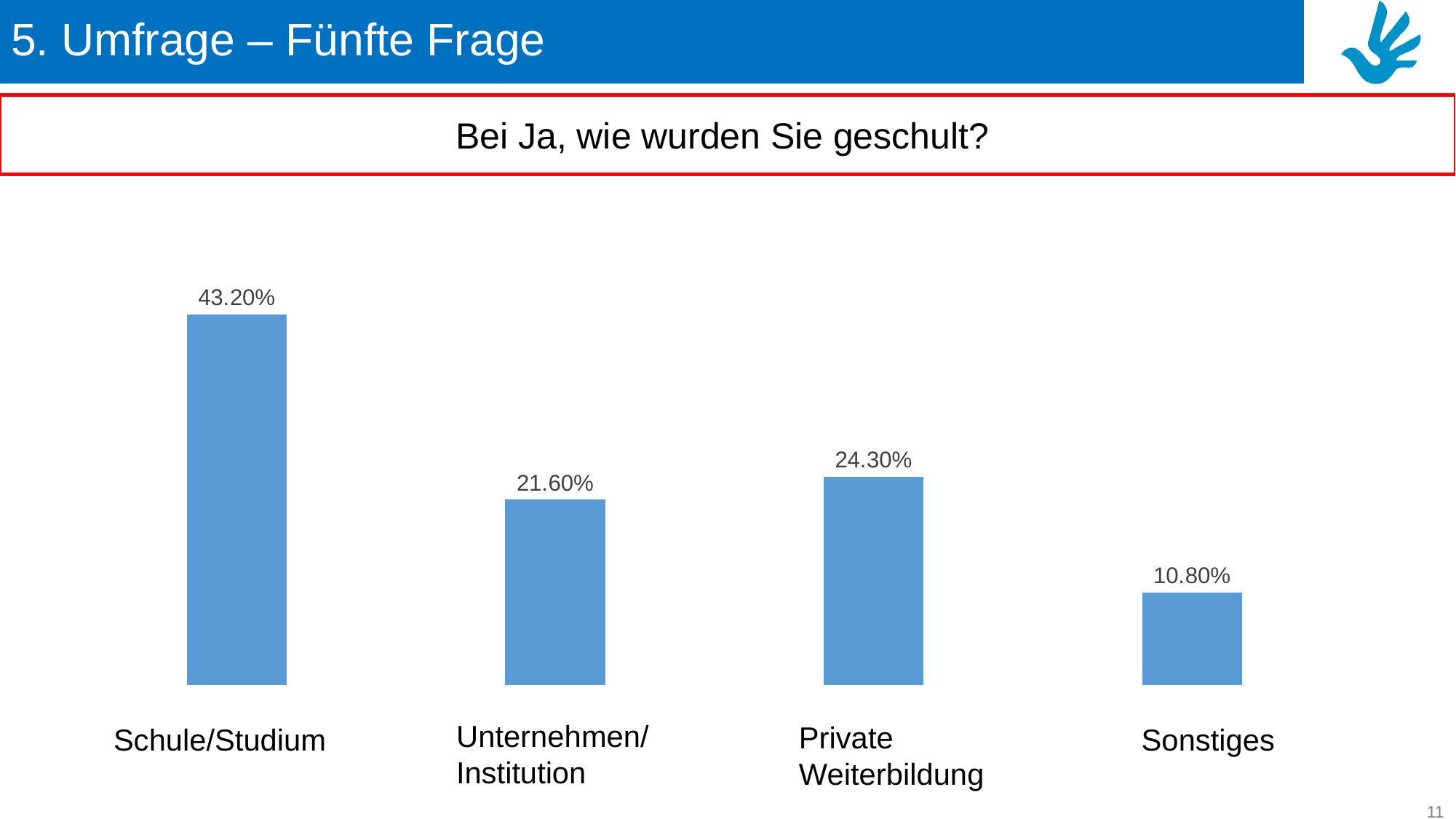
What is the value for Private Weiterbildung? 24.30% What kind of chart is shown on the slide? Bar chart What is the difference between the values for Private Weiterbildung and Unternehmen/Institution? 2.70% What is the value for Unternehmen/Institution? 21.60% What is the difference between the values for Schule/Studium and Sonstiges? 32.40% Which is larger, the value for Private Weiterbildung or the value for Unternehmen/Institution? Private Weiterbildung Which category has the highest value? Schule/Studium What question is the chart answering, as shown in the red box above it? Bei Ja, wie wurden Sie geschult? What is the value for Sonstiges? 10.80% What is the value for Schule/Studium? 43.20% How many categories are shown in the chart? 4 Which category has the lowest value? Sonstiges